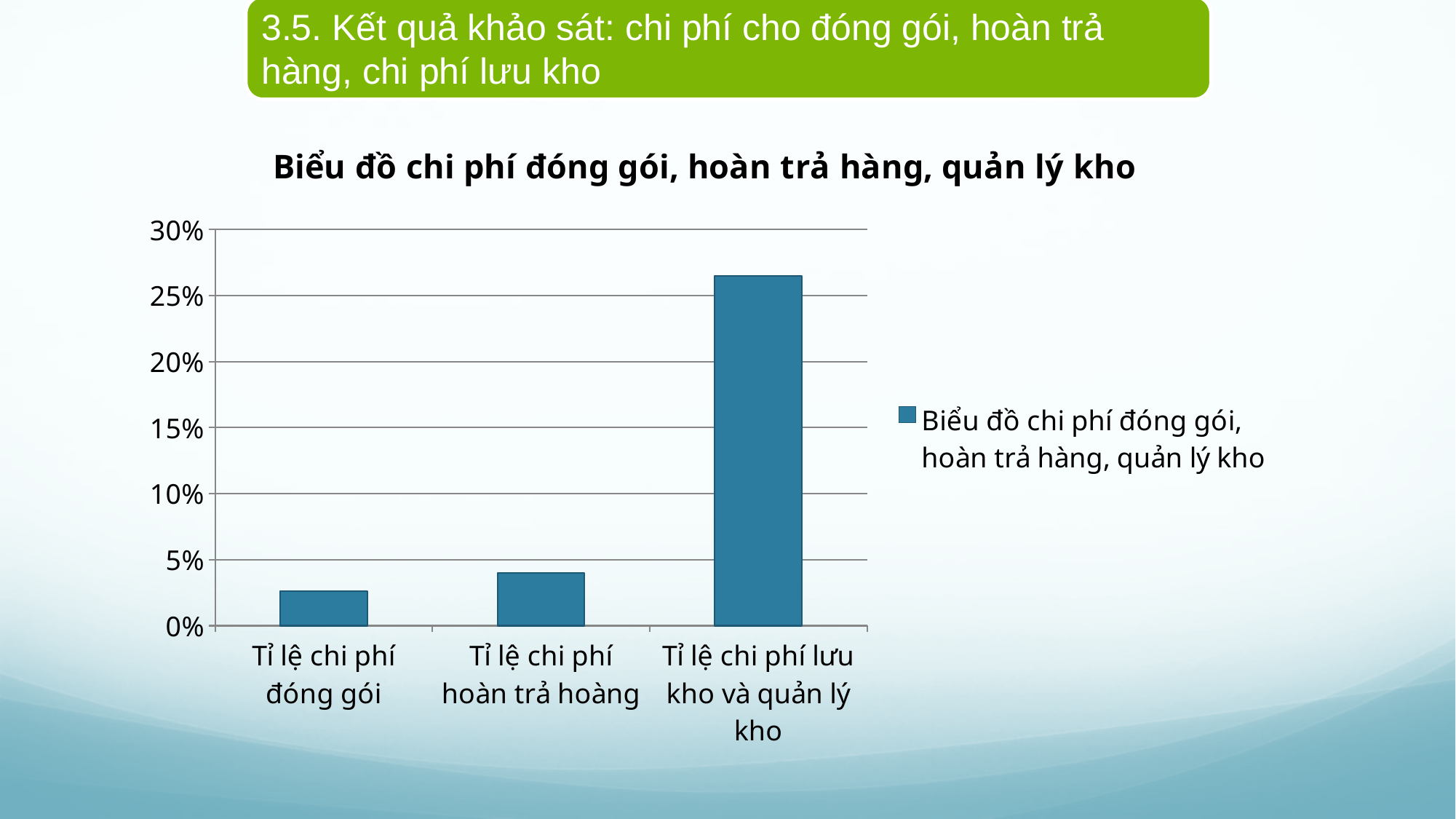
Which is larger: the value for Tỉ lệ chi phí hoàn trả hoàng or the value for Tỉ lệ chi phí lưu kho và quản lý kho? Tỉ lệ chi phí lưu kho và quản lý kho Which category has the highest value in the chart? Tỉ lệ chi phí lưu kho và quản lý kho What is the title of the chart? Biểu đồ chi phí đóng gói, hoàn trả hàng, quản lý kho What kind of chart is shown on the slide? bar chart How many categories are shown on the x axis of the chart? 3 Which is larger: the value for Tỉ lệ chi phí đóng gói or the value for Tỉ lệ chi phí hoàn trả hoàng? Tỉ lệ chi phí hoàn trả hoàng Do the values rise or fall from left to right along the x axis? rise How many series does the chart's legend list? 1 Is the value for Tỉ lệ chi phí đóng gói greater or less than 5%? less Is the value for Tỉ lệ chi phí hoàn trả hoàng greater or less than 5%? less Is the value for Tỉ lệ chi phí lưu kho và quản lý kho greater or less than 25%? greater Which category has the lowest value in the chart? Tỉ lệ chi phí đóng gói